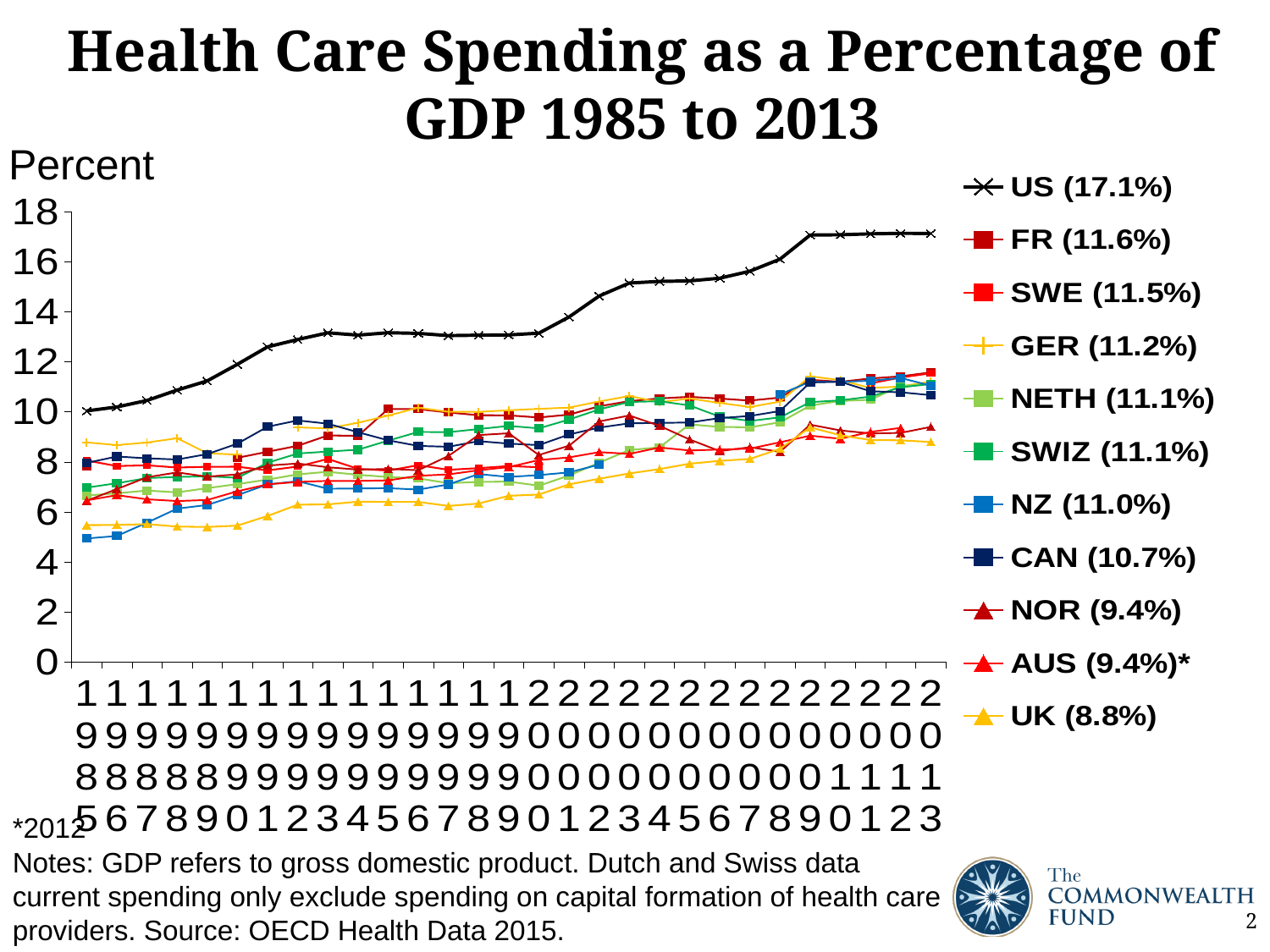
Which country has the highest health care spending as a percentage of GDP in 2013? US What value does the legend give for the US? 17.1% Which country has the lowest health care spending as a percentage of GDP in 2013? UK What kind of chart is shown on the slide? line chart According to the legend, which is larger, the value for FR or the value for SWE? FR Is the value for the US in 2000 greater or less than 14? less Does the US line generally rise or fall from 1985 to 2013? rise Is the value for the UK in 1985 greater or less than 6? less What is the difference in percentage points between the US (17.1%) and the UK (8.8%) values shown in the legend? 8.3 What value does the legend give for CAN? 10.7% How many series does the legend list? 11 What is the label on the vertical axis of the chart? Percent